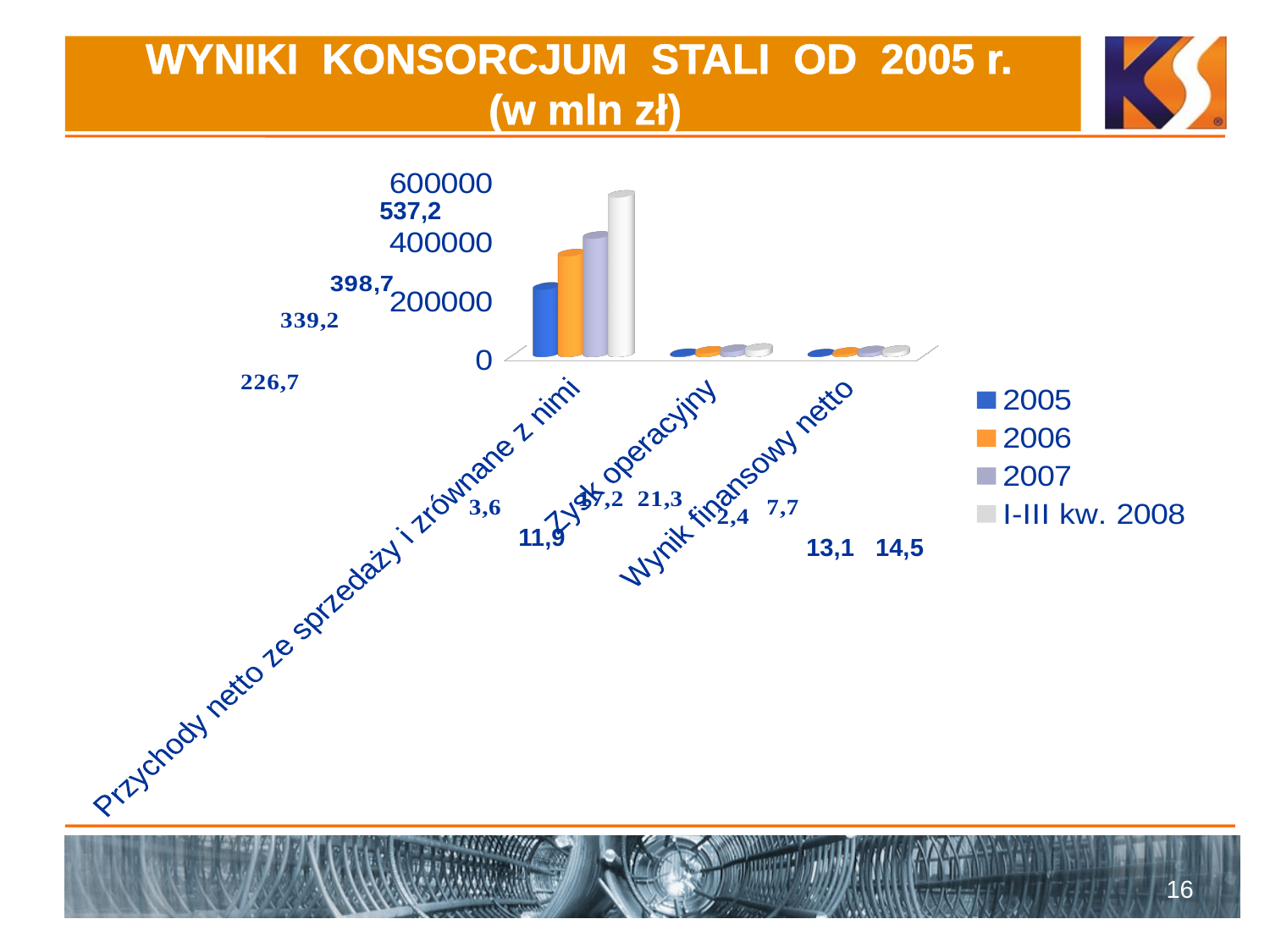
Which is larger among the 'Wynik finansowy netto' data labels, 13,1 or 14,5? 14,5 Which series does the last legend entry refer to? I-III kw. 2008 What is the highest data label shown for 'Przychody netto ze sprzedaży i zrównane z nimi'? 537,2 How many series does the legend list? 4 What is the difference between the highest (537,2) and lowest (226,7) data labels for 'Przychody netto ze sprzedaży i zrównane z nimi'? 310,5 Is the I-III kw. 2008 bar for 'Przychody netto ze sprzedaży i zrównane z nimi' greater or less than 400000 on the axis? greater What kind of chart is shown on the slide? bar chart Is the 2005 bar for 'Przychody netto ze sprzedaży i zrównane z nimi' greater or less than 400000 on the axis? less How many categories are shown on the x axis of the chart? 3 Which series has the tallest bar for 'Przychody netto ze sprzedaży i zrównane z nimi'? I-III kw. 2008 Do the bars for 'Przychody netto ze sprzedaży i zrównane z nimi' rise or fall from 2005 to I-III kw. 2008? rise Which series has the shortest bar for 'Przychody netto ze sprzedaży i zrównane z nimi'? 2005